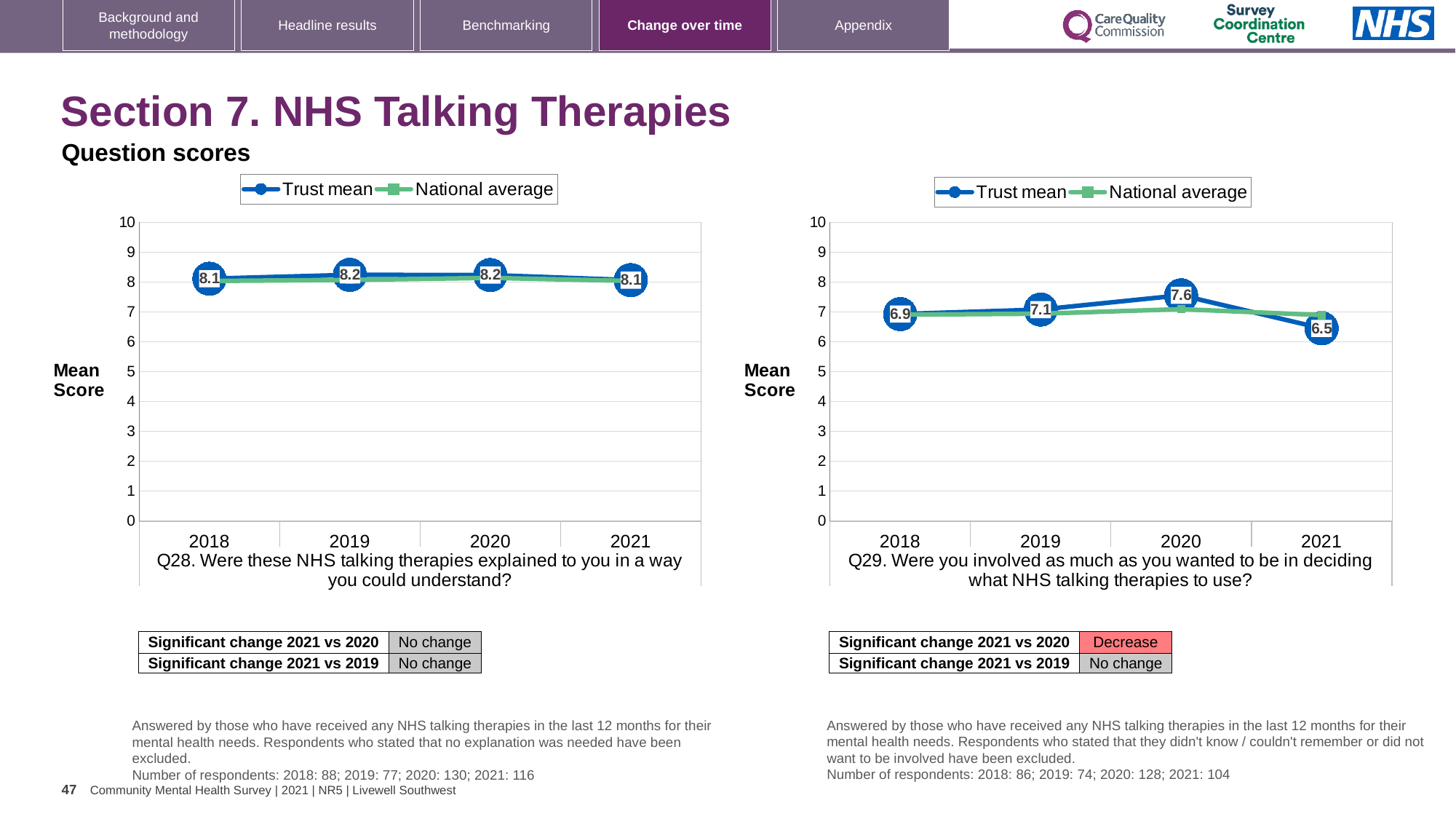
In the Q29 chart (right), what is the Trust mean for 2020? 7.6 In the Q29 chart (right), which year has the highest Trust mean? 2020 In the Q29 chart (right), what is the difference between the Trust mean for 2020 and the Trust mean for 2021? 1.1 In the Q28 chart (left), is the National average for 2020 greater or less than 7? greater In the Q29 chart (right), is the Trust mean higher in 2018 or in 2019? 2019 In the Q28 chart (left), what is the Trust mean for 2019? 8.2 How many years are shown on the x axis of the Q28 chart (left)? 4 What kind of chart is the Q28 chart (left)? Line chart In the Q28 chart (left), what is the Trust mean for 2021? 8.1 How many series does the legend of the Q29 chart (right) list? 2 In the Q29 chart (right), which year has the lowest Trust mean? 2021 In the Q29 chart (right), what is the Trust mean for 2021? 6.5